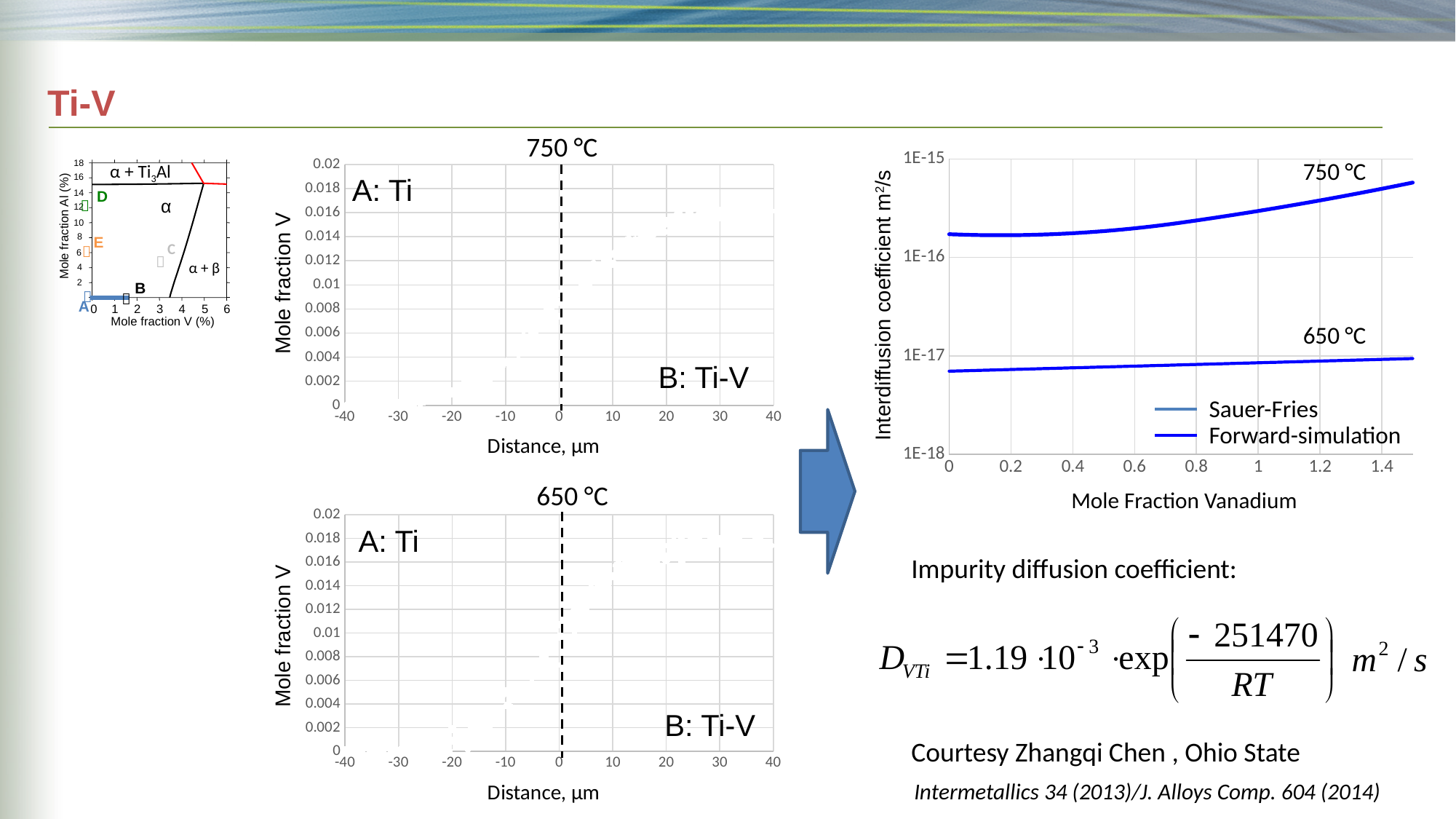
In the upper middle chart titled 750 °C, what is the label of the x axis? Distance, μm In the chart on the right (Interdiffusion coefficient vs Mole Fraction Vanadium), does the 750 °C curve rise or fall as mole fraction vanadium increases? rise In the chart on the right (Interdiffusion coefficient vs Mole Fraction Vanadium), how many series does the legend list? 2 In the chart on the right (Interdiffusion coefficient vs Mole Fraction Vanadium), what kind of chart is it? line chart In the lower middle chart titled 650 °C, what is the highest value shown on the y axis? 0.02 In the chart on the right (Interdiffusion coefficient vs Mole Fraction Vanadium), what is the highest tick value shown on the x axis? 1.4 In the chart on the right (Interdiffusion coefficient vs Mole Fraction Vanadium), what are the two legend entries? Sauer-Fries, Forward-simulation In the chart on the right (Interdiffusion coefficient vs Mole Fraction Vanadium), is the 750 °C curve at mole fraction 1.4 greater or less than 1E-16? greater In the chart on the right (Interdiffusion coefficient vs Mole Fraction Vanadium), is the 750 °C curve at mole fraction 0 greater or less than 1E-15? less In the chart on the right (Interdiffusion coefficient vs Mole Fraction Vanadium), is the 650 °C curve at mole fraction 0 greater or less than 1E-17? less In the chart on the right (Interdiffusion coefficient vs Mole Fraction Vanadium), which curve has the higher interdiffusion coefficient, 750 °C or 650 °C? 750 °C